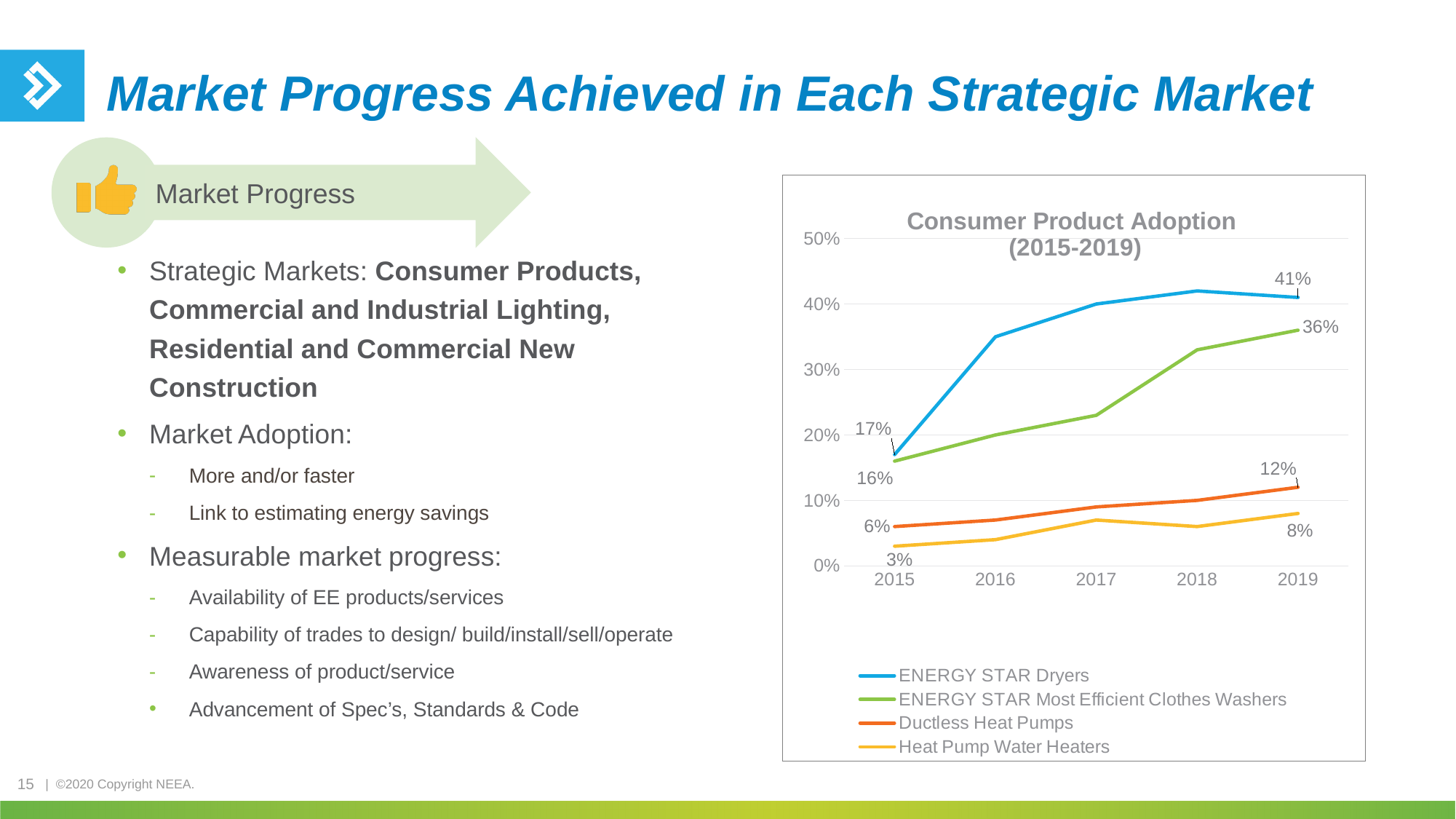
What was the adoption value for ENERGY STAR Dryers in 2019? 41% What was the adoption value for Ductless Heat Pumps in 2015? 6% How many years are shown on the x axis of the chart? 5 Which series had the highest adoption value in 2019? ENERGY STAR Dryers How many series does the chart legend list? 4 What is the title of the chart? Consumer Product Adoption (2015-2019) Which series had the lowest adoption value in 2015? Heat Pump Water Heaters Is the value for ENERGY STAR Most Efficient Clothes Washers in 2018 greater or less than 30%? greater What was the adoption value for ENERGY STAR Most Efficient Clothes Washers in 2015? 16% What type of chart is shown on the slide? line chart By how many percentage points did ENERGY STAR Dryers adoption increase from 2015 to 2019? 24 percentage points What was the adoption value for Heat Pump Water Heaters in 2019? 8%